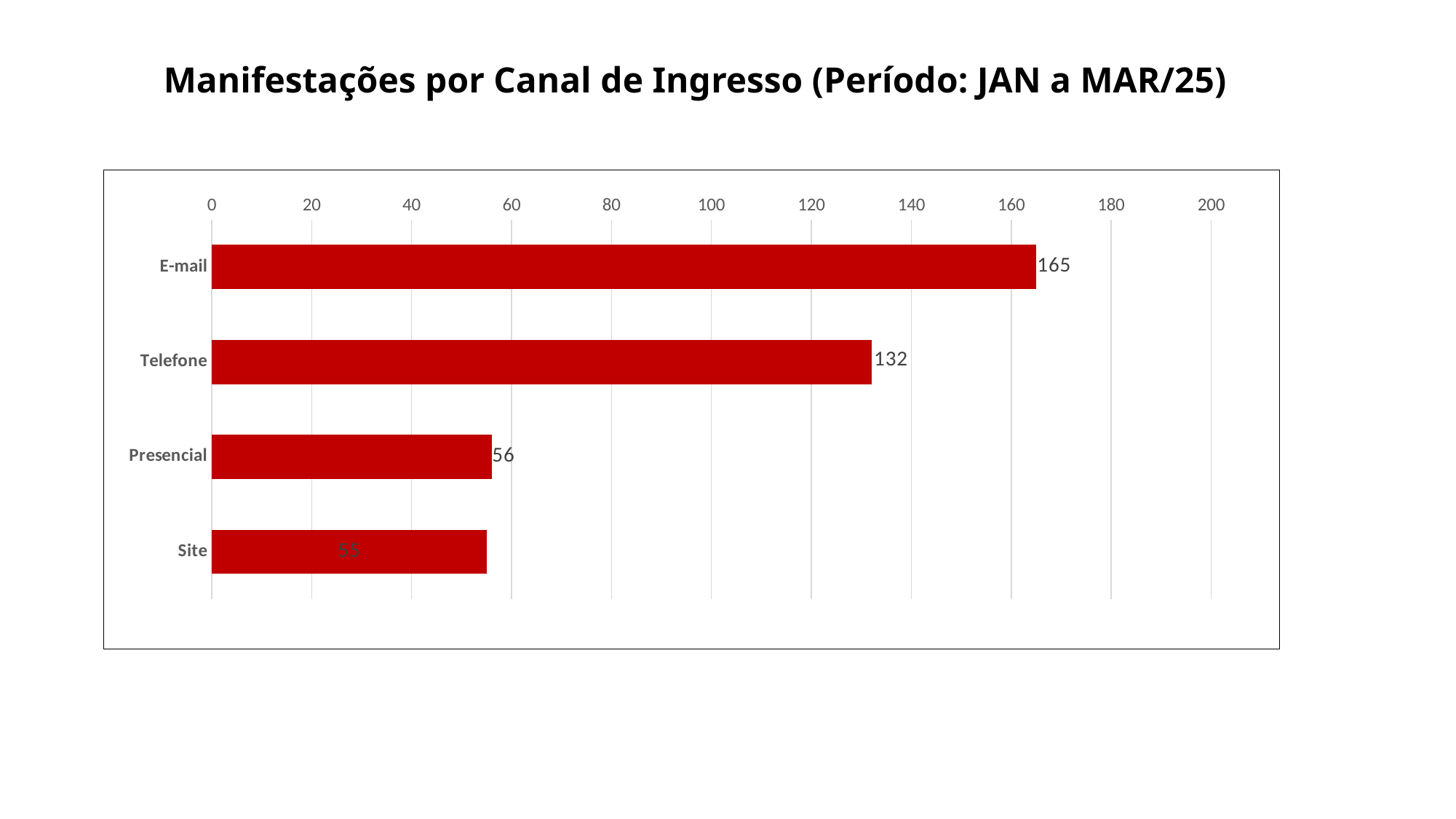
What is the value for Site? 55 What is the value for E-mail? 165 What is the difference between the values for Telefone and Presencial? 76 What is the value for Presencial? 56 How many channels are shown in the chart? 4 What is the title of the chart? Manifestações por Canal de Ingresso (Período: JAN a MAR/25) What is the value for Telefone? 132 Is the value for Telefone greater or less than 120? greater What is the difference between the values for E-mail and Telefone? 33 Which channel has the highest value? E-mail What kind of chart is shown on the slide? Bar chart Which is larger, the value for E-mail or the value for Presencial? E-mail